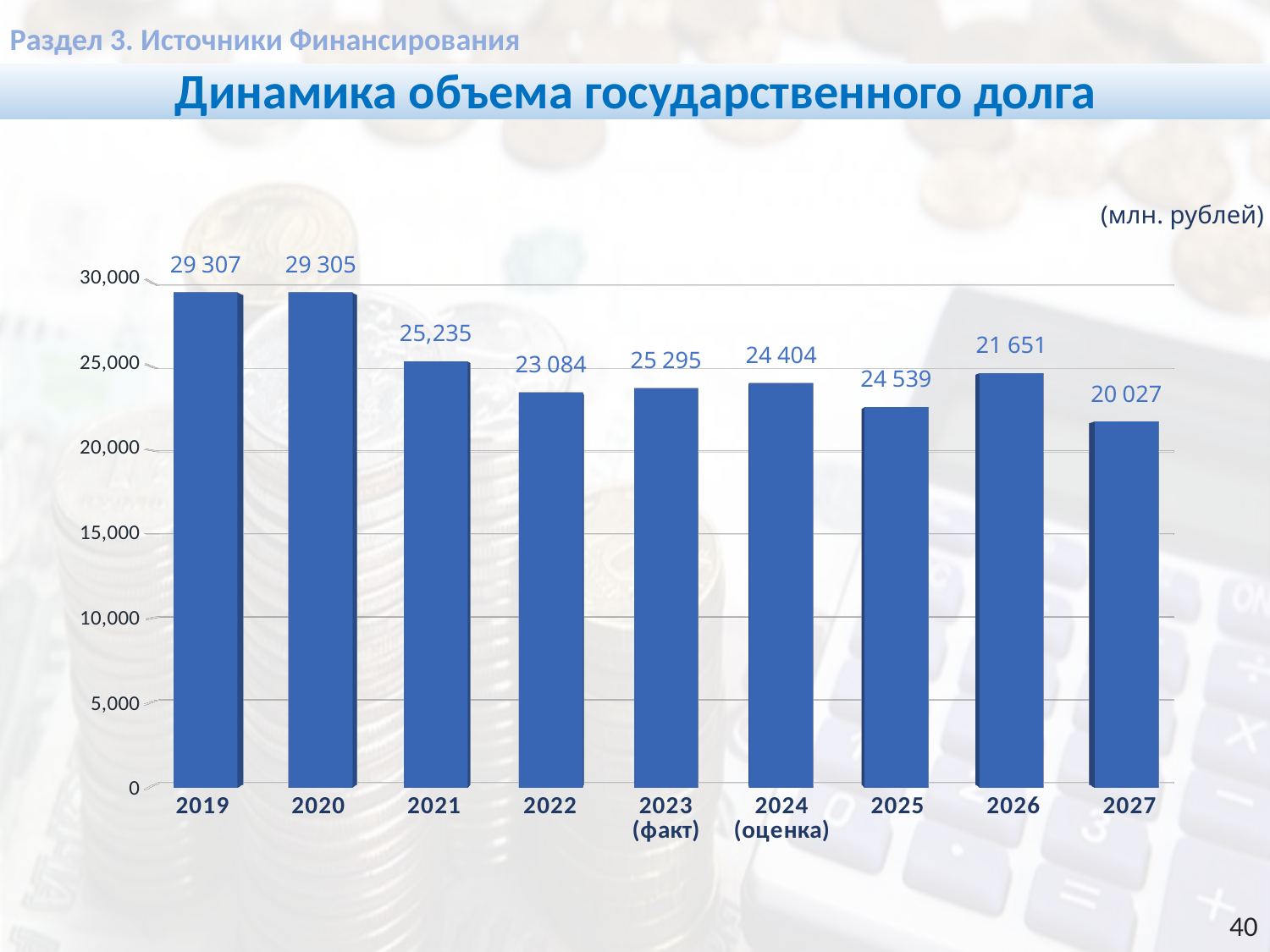
What is the value for 2024 (оценка)? 24 404 What is the value for 2021? 25,235 What unit is stated for the values on the chart? млн. рублей How many years are shown on the x axis? 9 Which is larger, the value for 2021 or the value for 2022? 2021 What is the difference between the values for 2026 and 2027? 1 624 Do the values generally rise or fall from 2019 to 2027? fall What kind of chart is shown on the slide? bar chart What is the value for 2027? 20 027 Is the value for 2027 greater or less than 25,000? less What is the value for 2019? 29 307 Which year has the lowest value? 2027